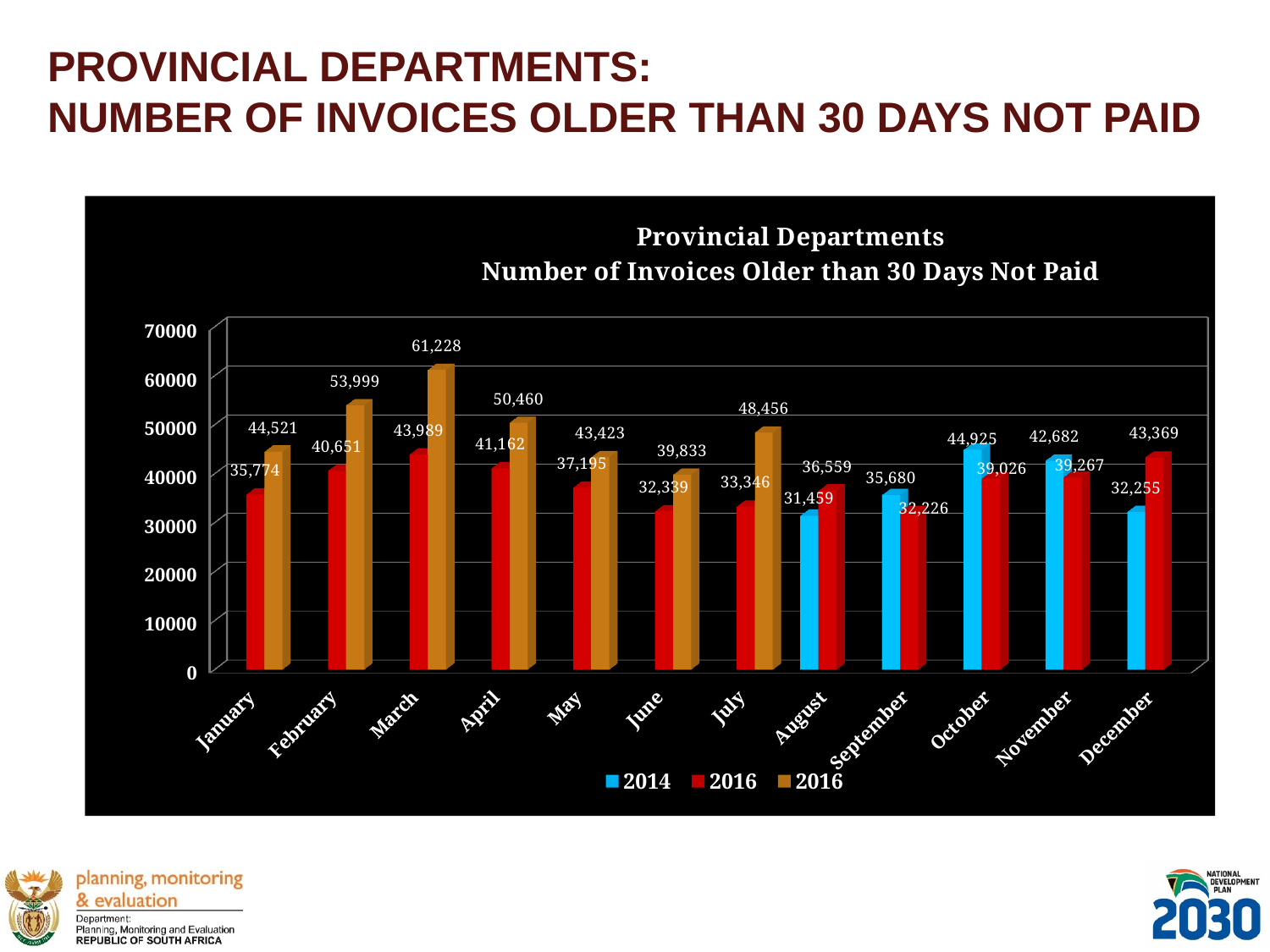
How many series does the chart's legend list? 3 How many months are shown along the x axis of the chart? 12 What is the value of the orange bar for March? 61,228 Which month has the highest value on the chart? March What is the difference between the orange bar and the red bar for March? 17,239 What is the value of the 2014 (blue) bar for October? 44,925 Which month has the lowest value on the chart? August Is the value of the orange bar for February greater or less than 50000? greater What kind of chart is shown on the slide? Bar chart What is the value of the red bar for December? 43,369 In September, which is larger: the 2014 (blue) bar or the red bar? The 2014 (blue) bar What are the legend entries of the chart, in order? 2014, 2016, 2016